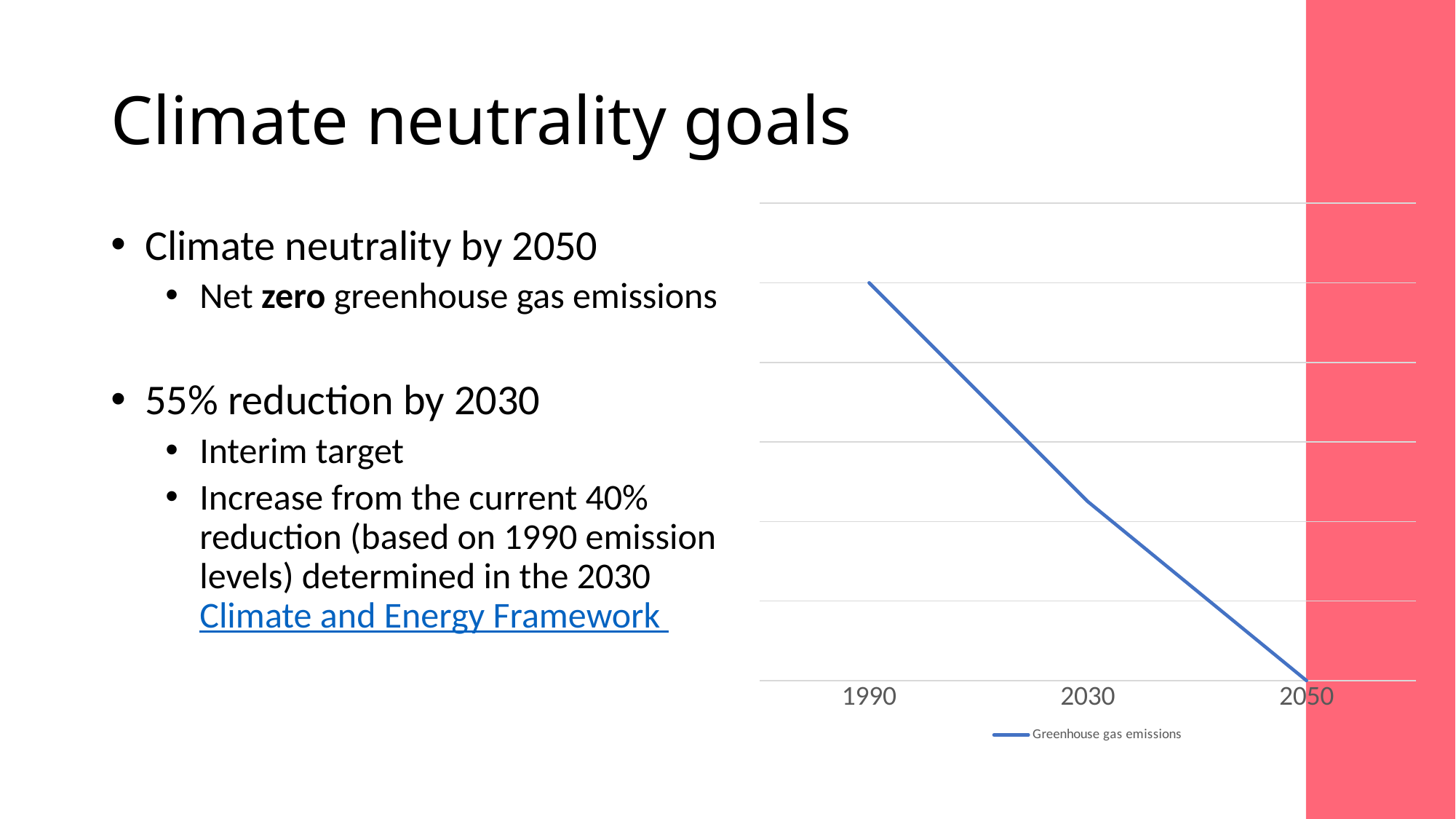
What is the name of the series shown in the chart's legend? Greenhouse gas emissions Which year has the larger greenhouse gas emissions value in the chart, 2030 or 2050? 2030 Which year has the larger greenhouse gas emissions value in the chart, 1990 or 2030? 1990 How many series does the chart's legend list? 1 Do the greenhouse gas emissions rise or fall from 1990 to 2050 in the chart? fall In which year is the greenhouse gas emissions value highest in the chart? 1990 What kind of chart is shown on the slide? line chart In which year is the greenhouse gas emissions value lowest in the chart? 2050 How many years are labelled on the x axis of the chart? 3 What is the first year labelled on the x axis of the chart? 1990